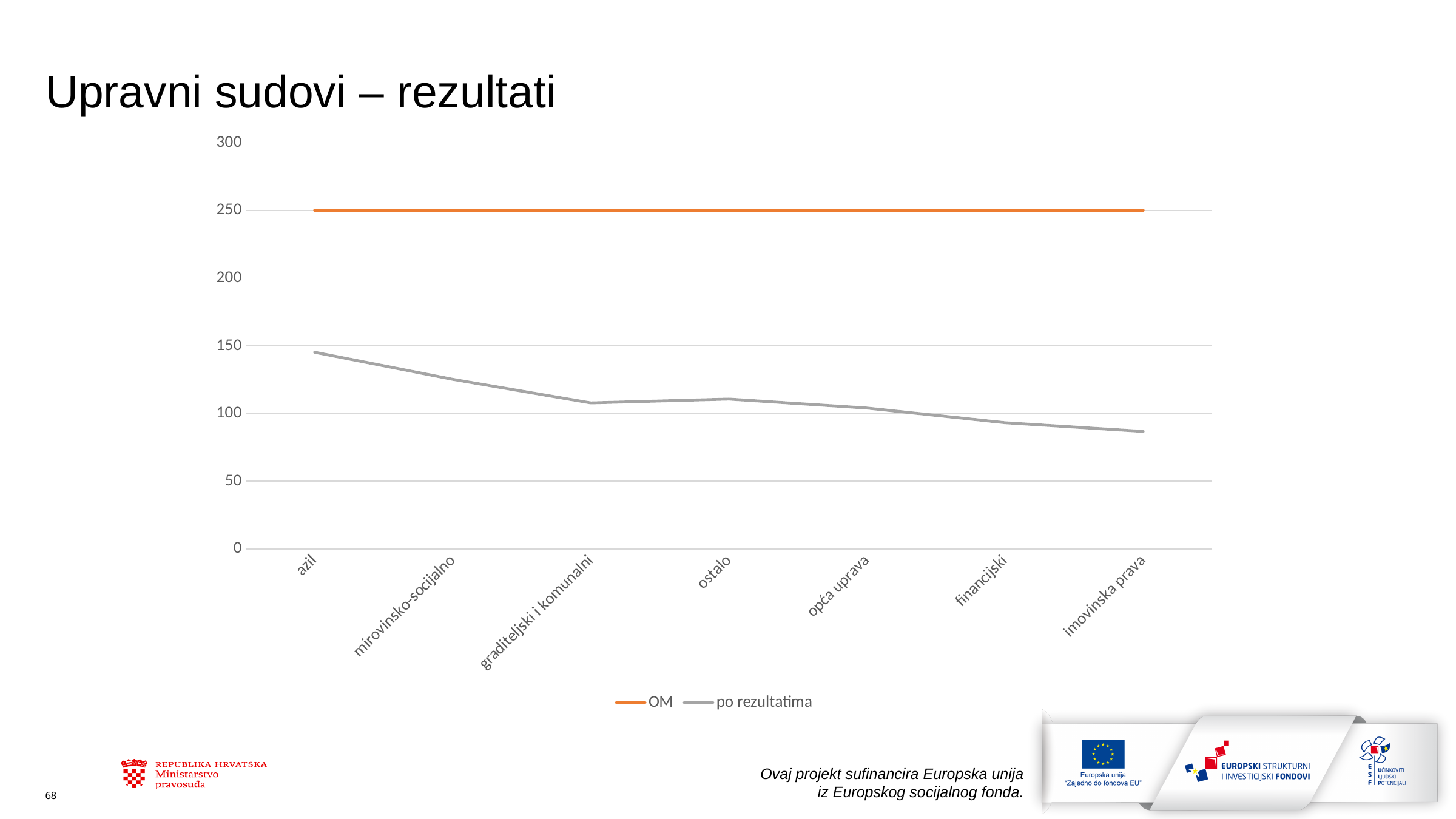
For ostalo, which series has the larger value, OM or 'po rezultatima'? OM What is the value of the OM series for azil? 250 How many series does the legend list? 2 What kind of chart is shown on the slide? line chart Is the 'po rezultatima' value for azil greater or less than 100? greater Which category has the highest value for 'po rezultatima'? azil How many categories are shown on the x axis? 7 Is the 'po rezultatima' value for imovinska prava greater or less than 100? less Is the 'po rezultatima' value for mirovinsko-socijalno greater or less than 150? less Which category has the lowest value for 'po rezultatima'? imovinska prava Does the 'po rezultatima' series generally rise or fall from azil to imovinska prava? fall What colour is the OM line? orange